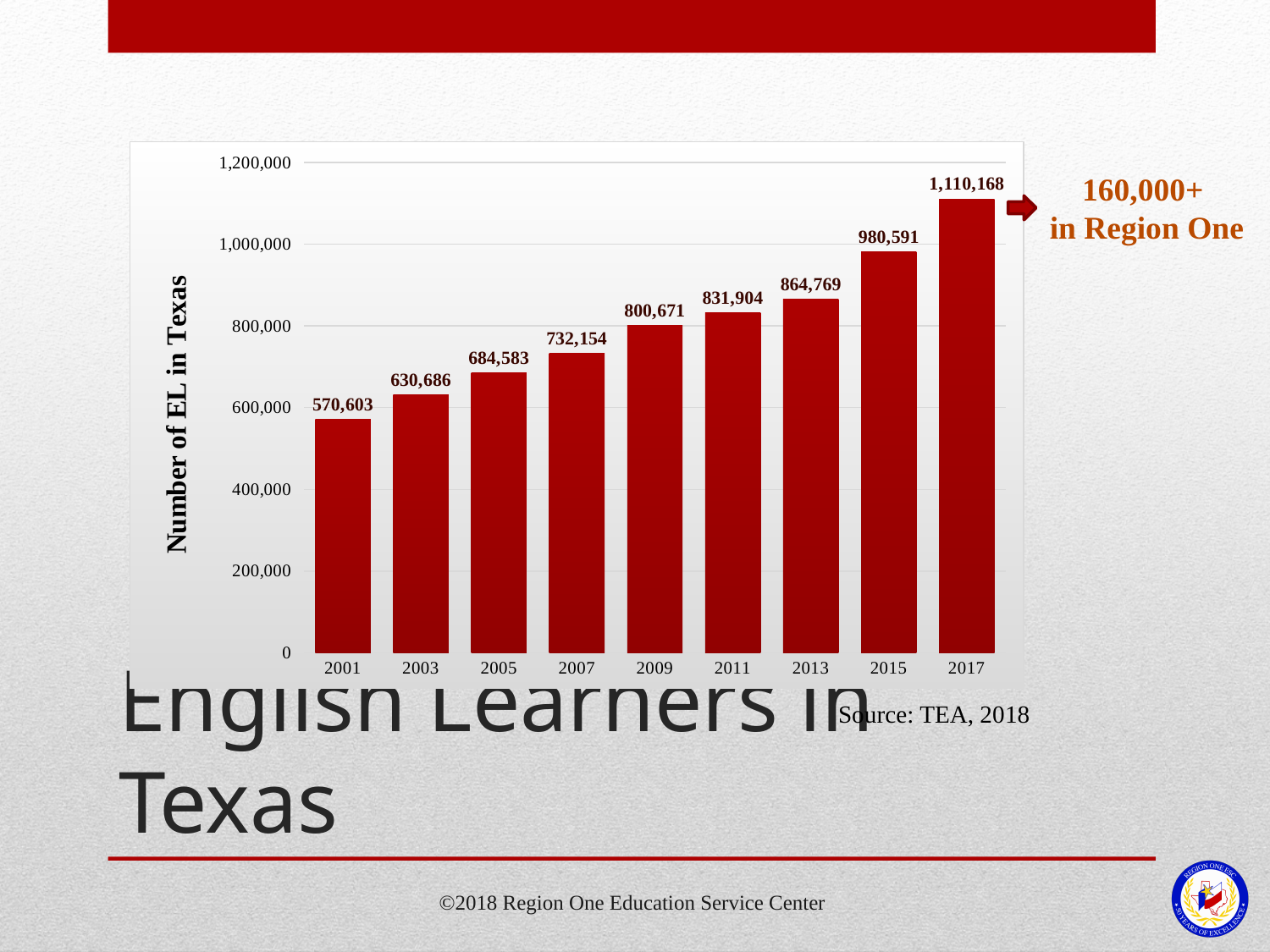
What is the difference between the number of EL in Texas in 2017 and in 2015? 129,577 Do the values rise or fall from 2001 to 2017? rise What is the difference between the number of EL in Texas in 2003 and in 2001? 60,083 Which year has a larger number of EL in Texas, 2011 or 2013? 2013 What is the number of EL in Texas in 2009? 800,671 What kind of chart is shown on the slide? bar chart How many years are shown on the x axis of the chart? 9 What is the number of EL in Texas in 2001? 570,603 Is the number of EL in Texas in 2015 greater or less than 1,000,000? less What is the number of EL in Texas in 2017? 1,110,168 Which year has the lowest number of EL in Texas? 2001 Which year has the highest number of EL in Texas? 2017